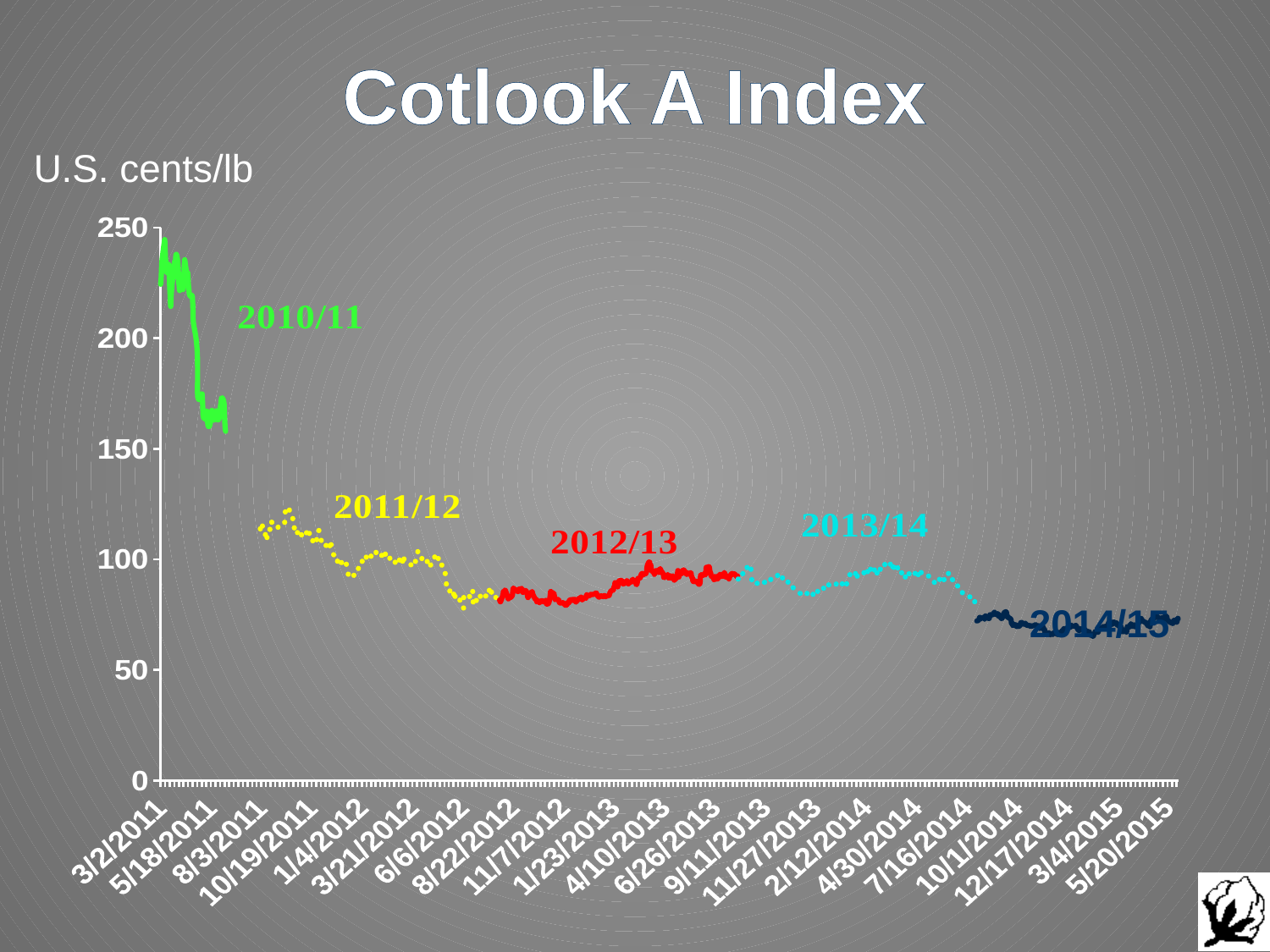
What is the title of the chart? Cotlook A Index What kind of chart is shown on the slide? line chart Does the 2010/11 series rise or fall over its period on the chart? fall Which series has higher values, 2010/11 or 2014/15? 2010/11 Which season's series has the lowest values on the chart? 2014/15 How many seasons (series) are labelled on the chart? 5 Are the values of the 2012/13 series greater or less than 150? less Is the value of the 2010/11 series at the start of the chart (around 3/2/2011) greater or less than 200? greater Are the values of the 2014/15 series greater or less than 50? greater Which season's series reaches the highest values on the chart? 2010/11 What unit is the Cotlook A Index plotted in, according to the label above the chart? U.S. cents/lb